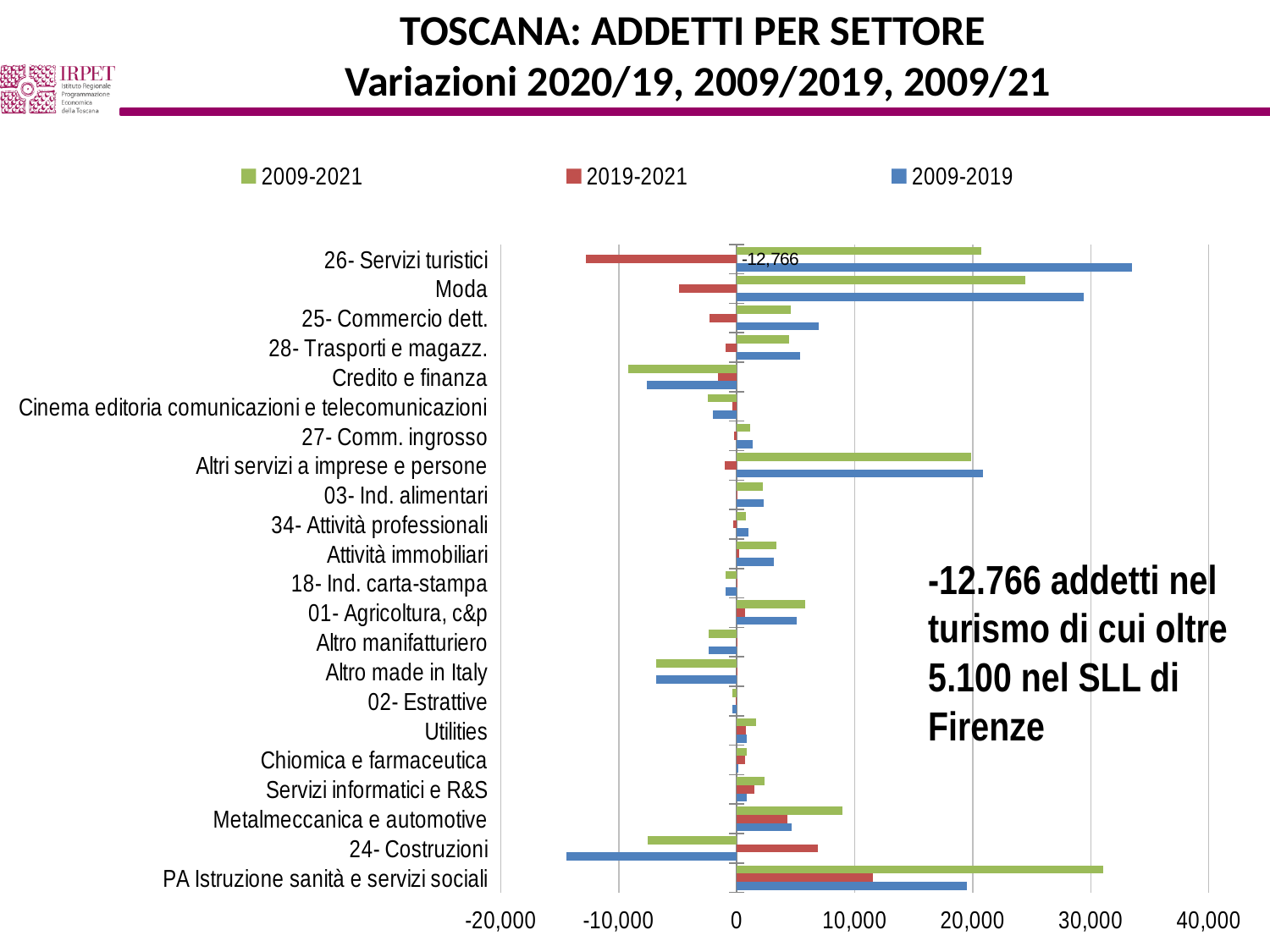
Which has the larger 2009-2019 value, Moda or 25- Commercio dett.? Moda Which category has the lowest 2019-2021 value? 26- Servizi turistici Is the 2009-2019 value for 26- Servizi turistici greater or less than 30,000? greater Which category has the highest 2009-2021 value? PA Istruzione sanità e servizi sociali Which category has the highest 2019-2021 value? PA Istruzione sanità e servizi sociali Which category has the highest 2009-2019 value? 26- Servizi turistici What is the 2019-2021 value for 26- Servizi turistici? -12,766 How many sector categories are plotted on the chart? 22 How many series does the legend list? 3 Is the 2009-2019 value for 24- Costruzioni greater or less than -10,000? less Which category has the lowest 2009-2019 value? 24- Costruzioni What kind of chart is shown on the slide? bar chart